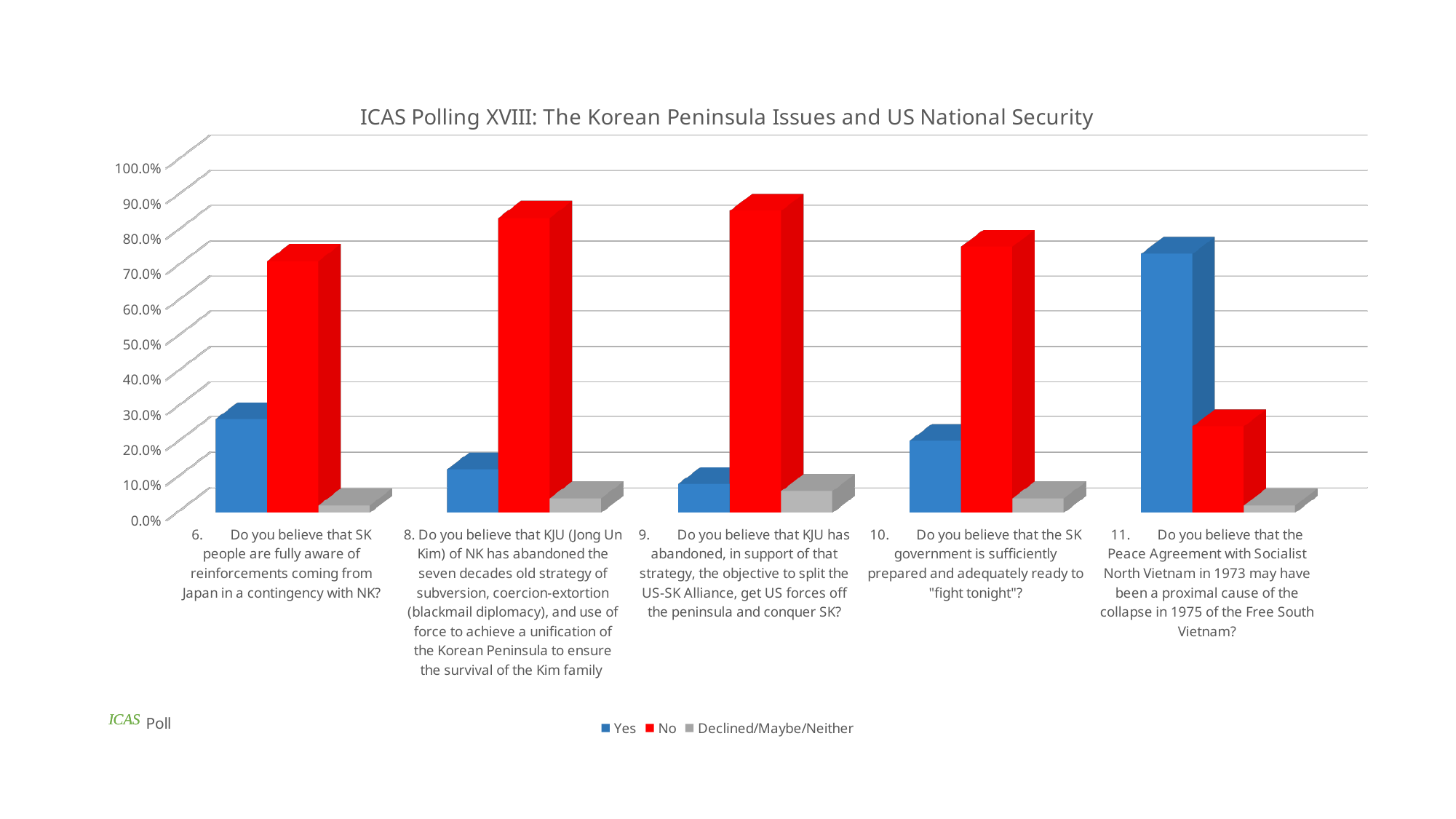
Which poll question has the lowest "Yes" value? 9 Which poll question has the highest "Yes" value? 11 Is the "No" value for question 9 greater or less than 80.0%? greater Is the "Yes" value for question 11 greater or less than 50.0%? greater For question 11, which is larger, the "Yes" value or the "No" value? Yes How many poll questions (categories) are plotted on the x axis? 5 How many series does the legend list? 3 What kind of chart is shown on the slide? bar chart Is the "No" value for question 11 greater or less than 50.0%? less Which colour represents the "No" series in the legend? red What is the title of the chart? ICAS Polling XVIII: The Korean Peninsula Issues and US National Security